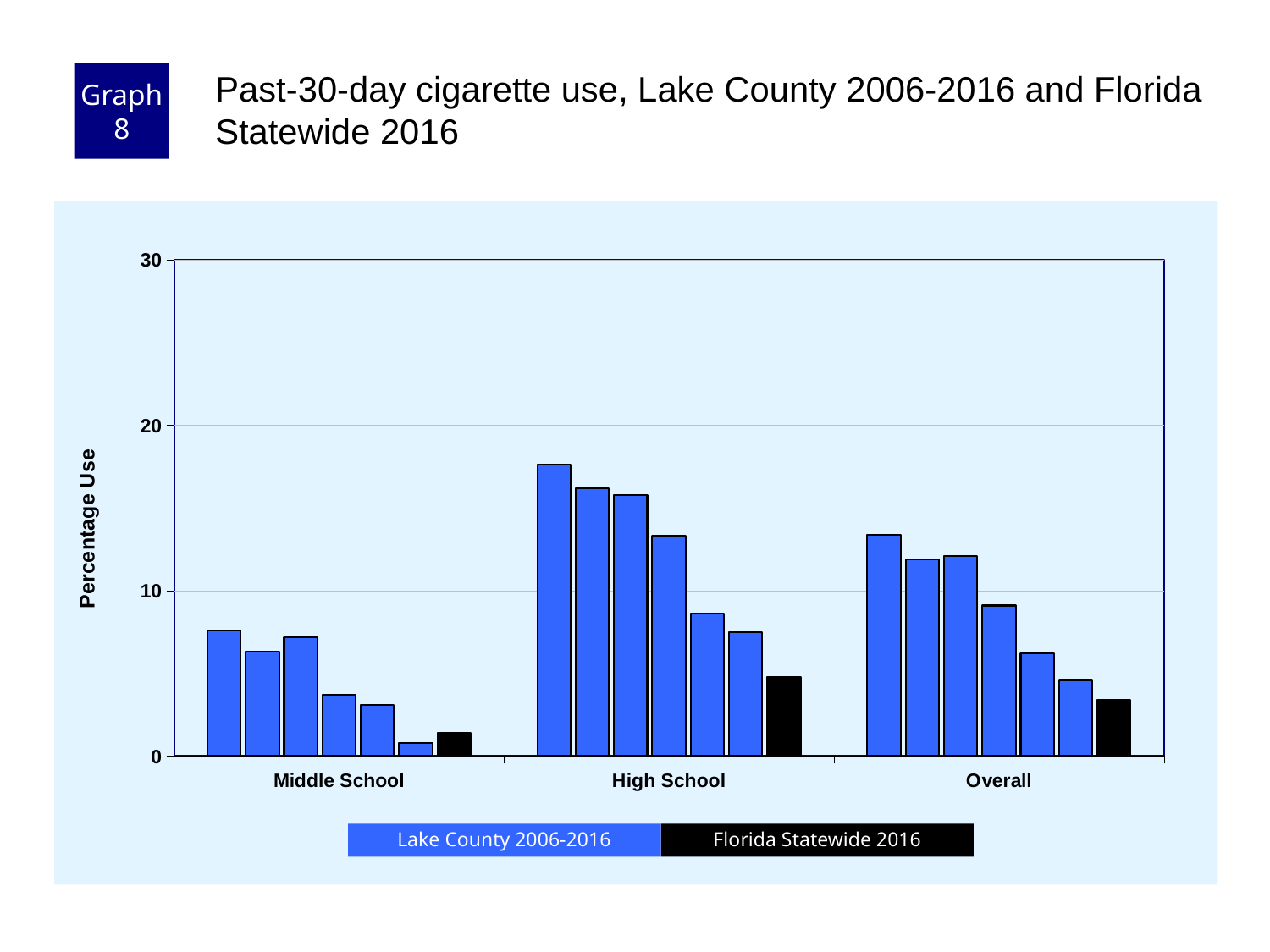
Is the tallest Lake County 2006-2016 bar for High School greater or less than 20? less What kind of chart is shown on the slide? bar chart How many categories are shown on the x axis? 3 What is the title of the y axis? Percentage Use Which is larger: the Florida Statewide 2016 value for High School or for Middle School? High School Within the High School group, do the Lake County 2006-2016 bars generally rise or fall from left to right? fall Which category has the lowest Florida Statewide 2016 bar? Middle School Is the tallest Lake County 2006-2016 bar for Overall greater or less than 10? greater How many series does the legend list? 2 Is the Florida Statewide 2016 value for Middle School greater or less than 10? less Which category has the tallest bar in the chart? High School